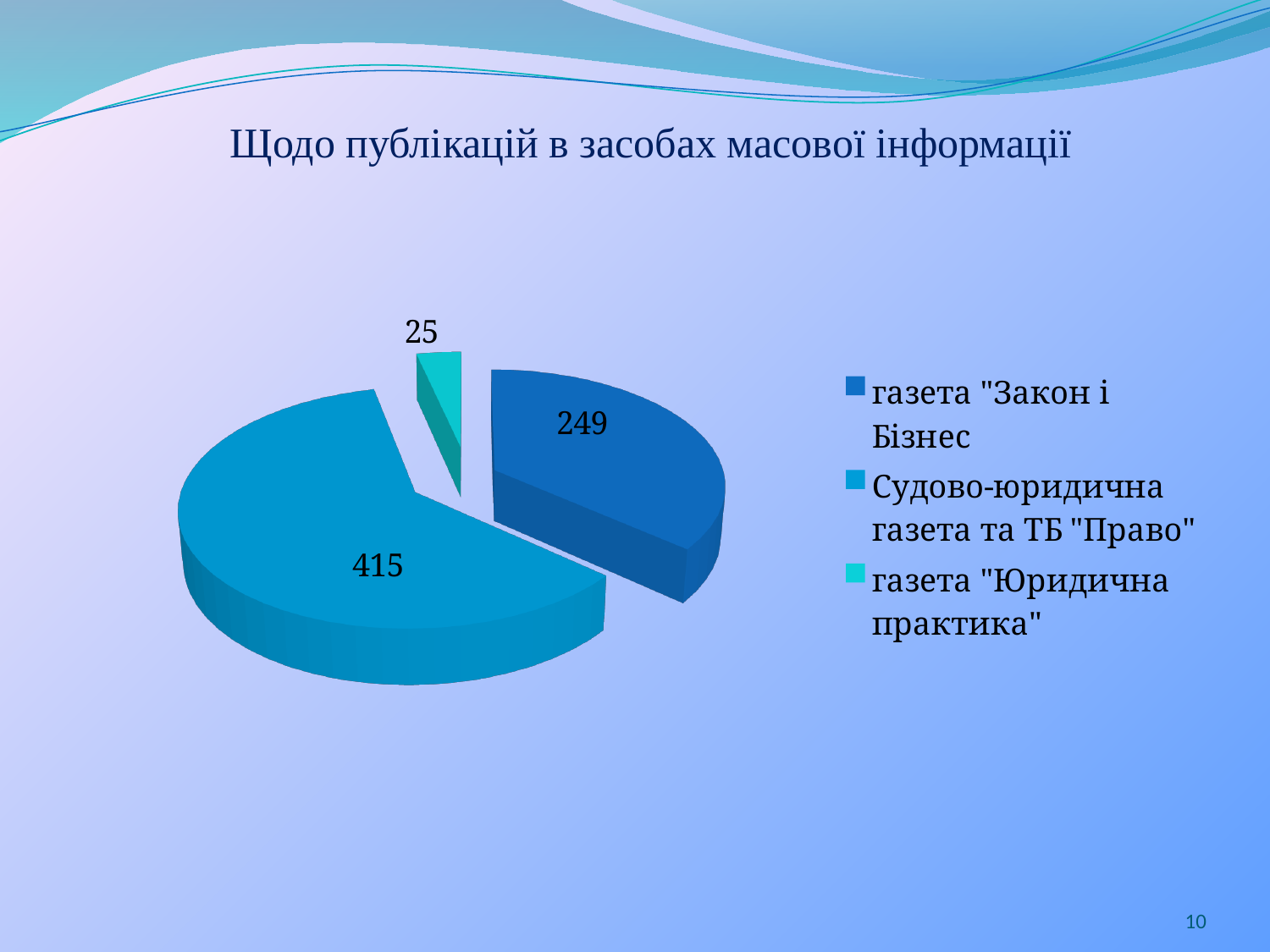
What is the difference between the values for Судово-юридична газета та ТБ "Право" and газета "Закон і Бізнес"? 166 Which is larger: the value for газета "Закон і Бізнес" or the value for газета "Юридична практика"? газета "Закон і Бізнес" Which category has the smallest slice of the pie? газета "Юридична практика" What is the difference between the values for газета "Закон і Бізнес" and газета "Юридична практика"? 224 Which category has the largest slice of the pie? Судово-юридична газета та ТБ "Право" What type of chart is shown on the slide? pie chart What is the value for газета "Юридична практика"? 25 How many slices does the pie chart have? 3 What is the title of the chart on the slide? Щодо публікацій в засобах масової інформації What is the value for Судово-юридична газета та ТБ "Право"? 415 What is the value for газета "Закон і Бізнес"? 249 What is the total of all the values shown in the pie chart? 689